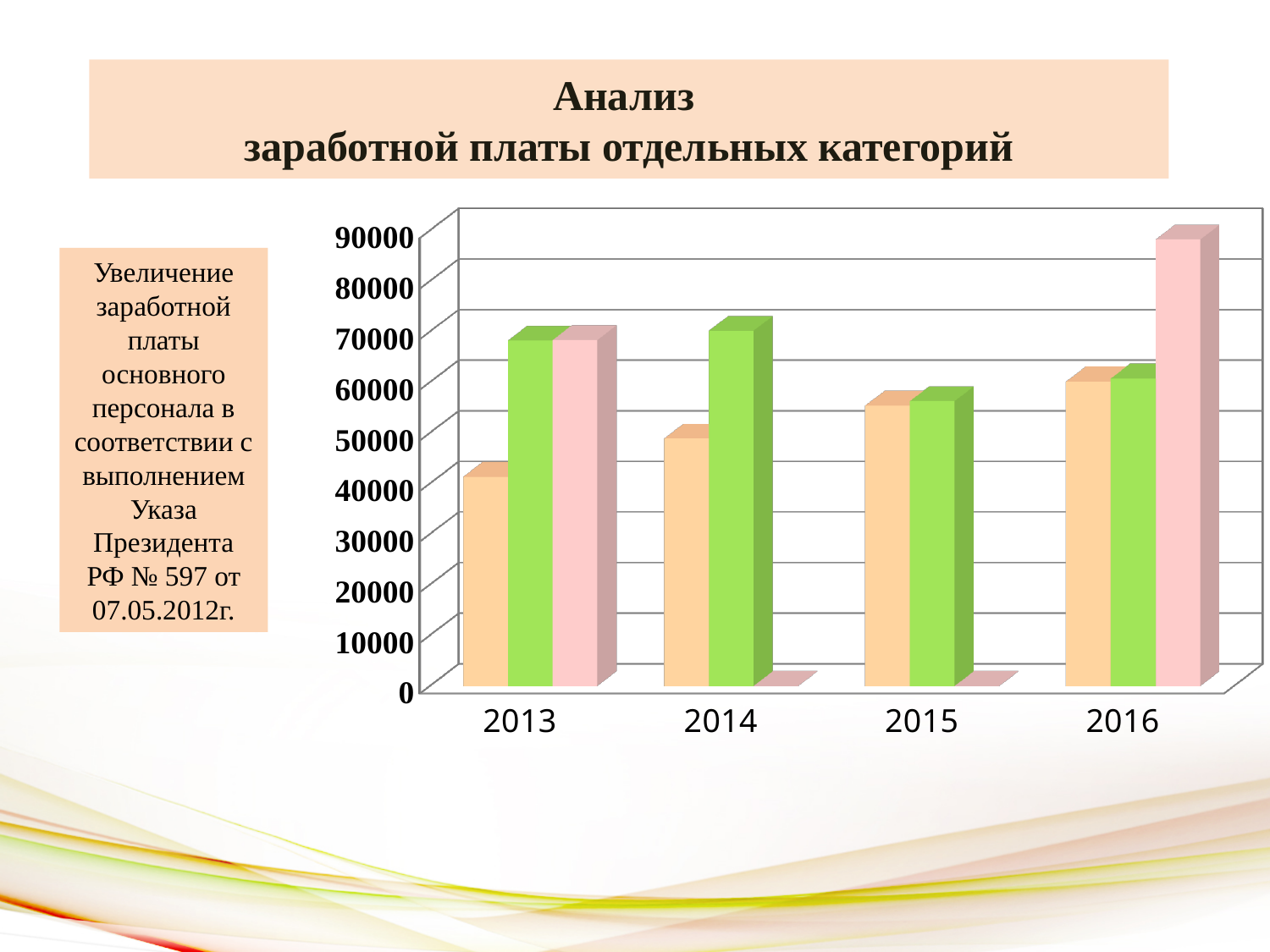
Is the value of the green bar for 2013 greater or less than 60000? greater Which is larger in 2014: the orange bar or the green bar? the green bar Is the value of the green bar for 2014 greater or less than 60000? greater How many years are shown on the x axis of the chart? 4 Which years are shown on the x axis of the chart? 2013, 2014, 2015, 2016 Is the value of the pink bar for 2016 greater or less than 80000? greater What kind of chart is shown on the slide? bar chart In which year is the pink bar the highest? 2016 Do the values of the orange bars rise or fall from 2013 to 2016? rise In which year is the orange bar the lowest? 2013